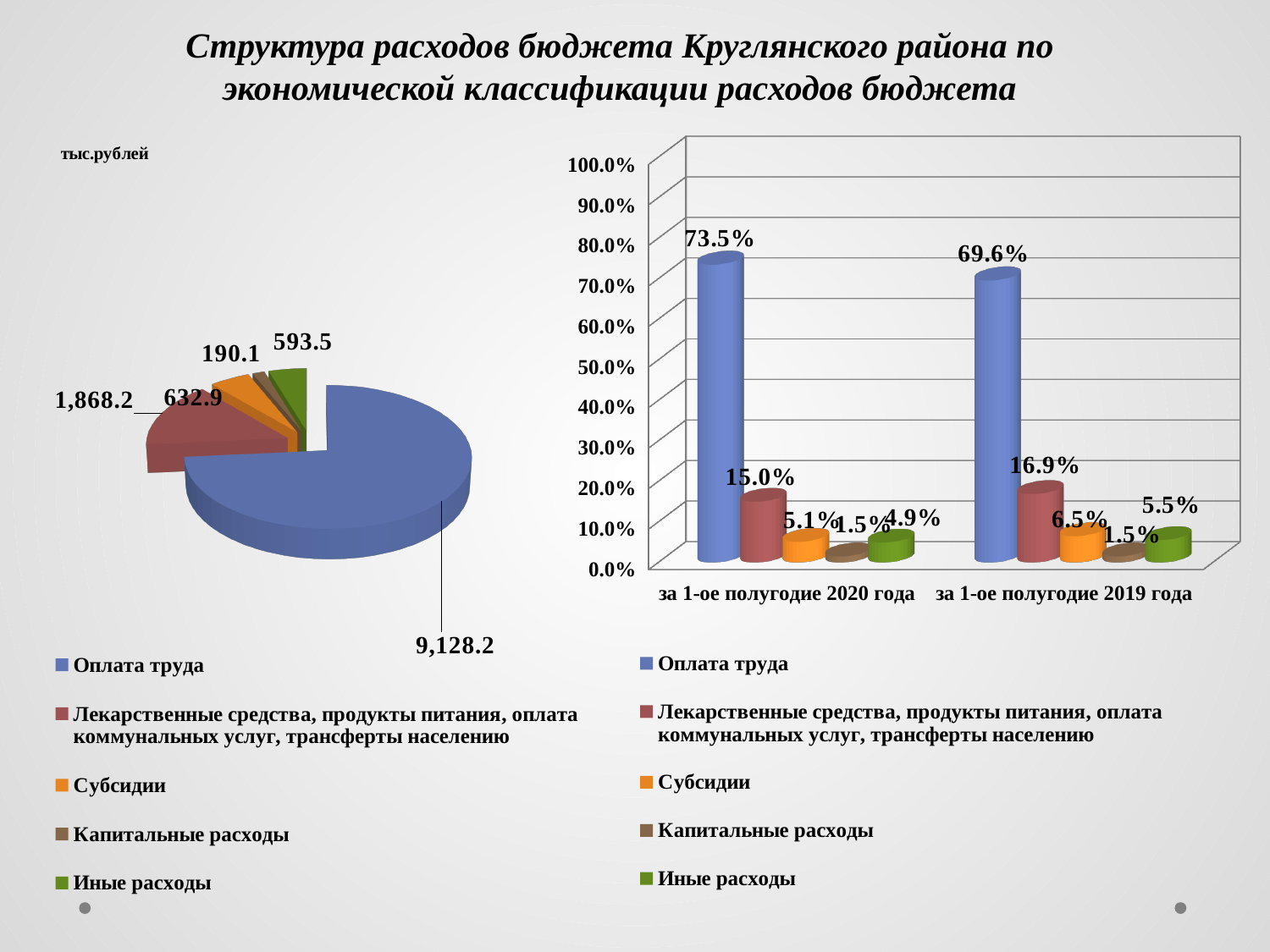
In the pie chart on the left, which category has the smallest slice? Капитальные расходы In the bar chart on the right, how many series does the legend list? 5 In the bar chart on the right, what is the value for Оплата труда for за 1-ое полугодие 2020 года? 73.5% What kind of chart is shown on the right side of the slide? Bar chart In the bar chart on the right, which is larger: Оплата труда for за 1-ое полугодие 2020 года or for за 1-ое полугодие 2019 года? за 1-ое полугодие 2020 года In the pie chart on the left, how many slices are there? 5 In the bar chart on the right, what is the value for Субсидии for за 1-ое полугодие 2019 года? 6.5% In the pie chart on the left, what is the difference between the values for Субсидии and Иные расходы? 39.4 In the bar chart on the right, what is the difference between the Лекарственные средства values for за 1-ое полугодие 2019 года and за 1-ое полугодие 2020 года? 1.9% In the pie chart on the left, what is the value for Капитальные расходы? 190.1 What unit is indicated above the pie chart on the left? тыс.рублей In the pie chart on the left, what is the value for Оплата труда? 9,128.2